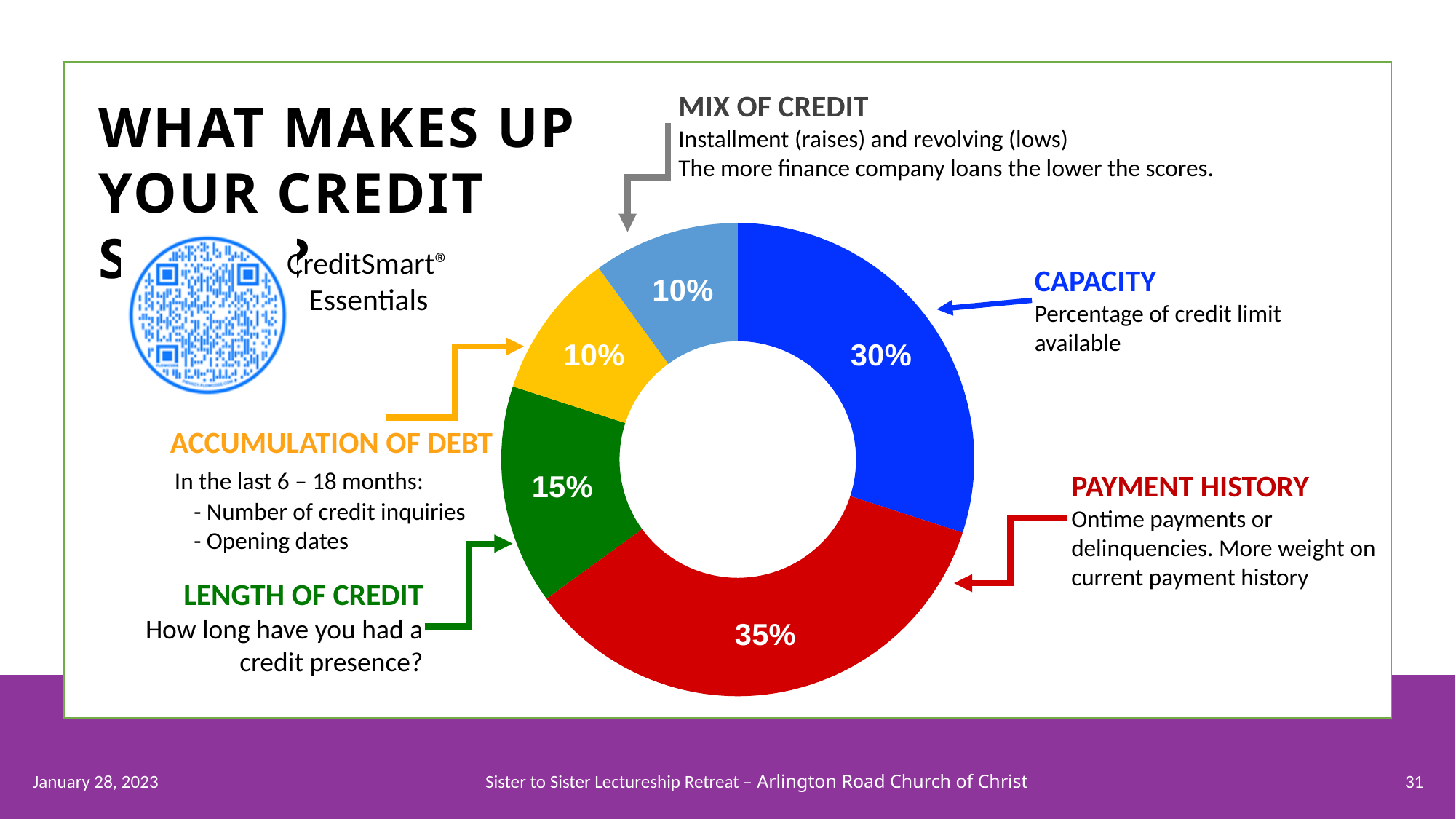
What percentage of the credit score does Payment History make up? 35% What percentage of the credit score does Mix of Credit make up? 10% Which is larger, the share for Length of Credit or the share for Accumulation of Debt? Length of Credit What colour is the segment for Length of Credit? Green What is the difference between the Payment History share and the Capacity share? 5% What percentage of the credit score does Length of Credit make up? 15% What colour is the segment for Accumulation of Debt? Yellow What percentage of the credit score does Capacity make up? 30% How many segments does the chart have? 5 Which factor makes up the largest share of the credit score? Payment History What is the combined share of Capacity and Payment History? 65% What kind of chart is shown on the slide? Donut (pie) chart